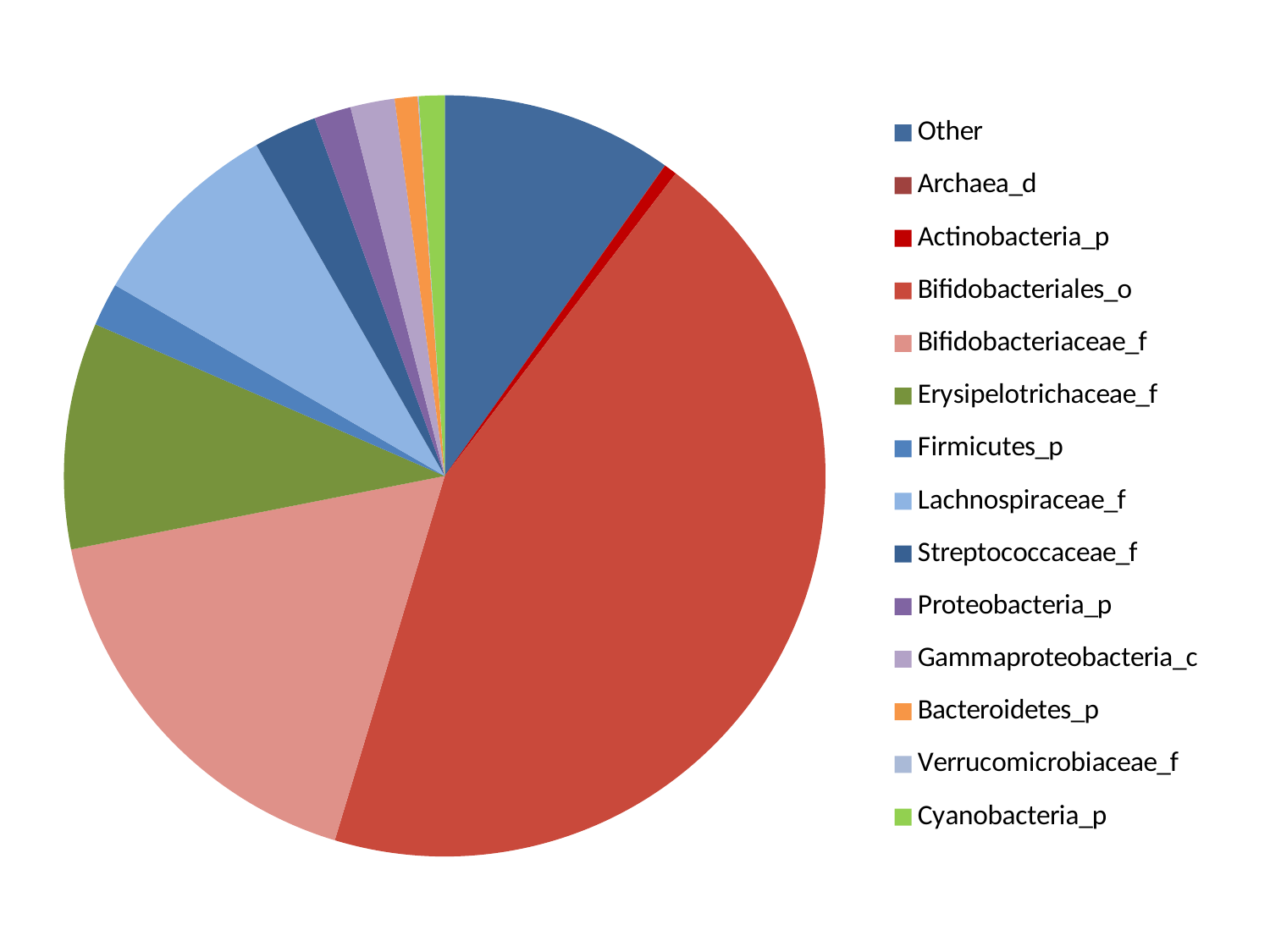
Which slice is larger, Bifidobacteriaceae_f or Erysipelotrichaceae_f? Bifidobacteriaceae_f Which category is listed first in the legend of the pie chart? Other Which slice is larger, Bifidobacteriales_o or Other? Bifidobacteriales_o How many categories does the legend of the pie chart list? 14 Which category has the largest slice of the pie chart? Bifidobacteriales_o Which slice is larger, Lachnospiraceae_f or Firmicutes_p? Lachnospiraceae_f What kind of chart is shown on the slide? pie chart Which category is listed last in the legend of the pie chart? Cyanobacteria_p